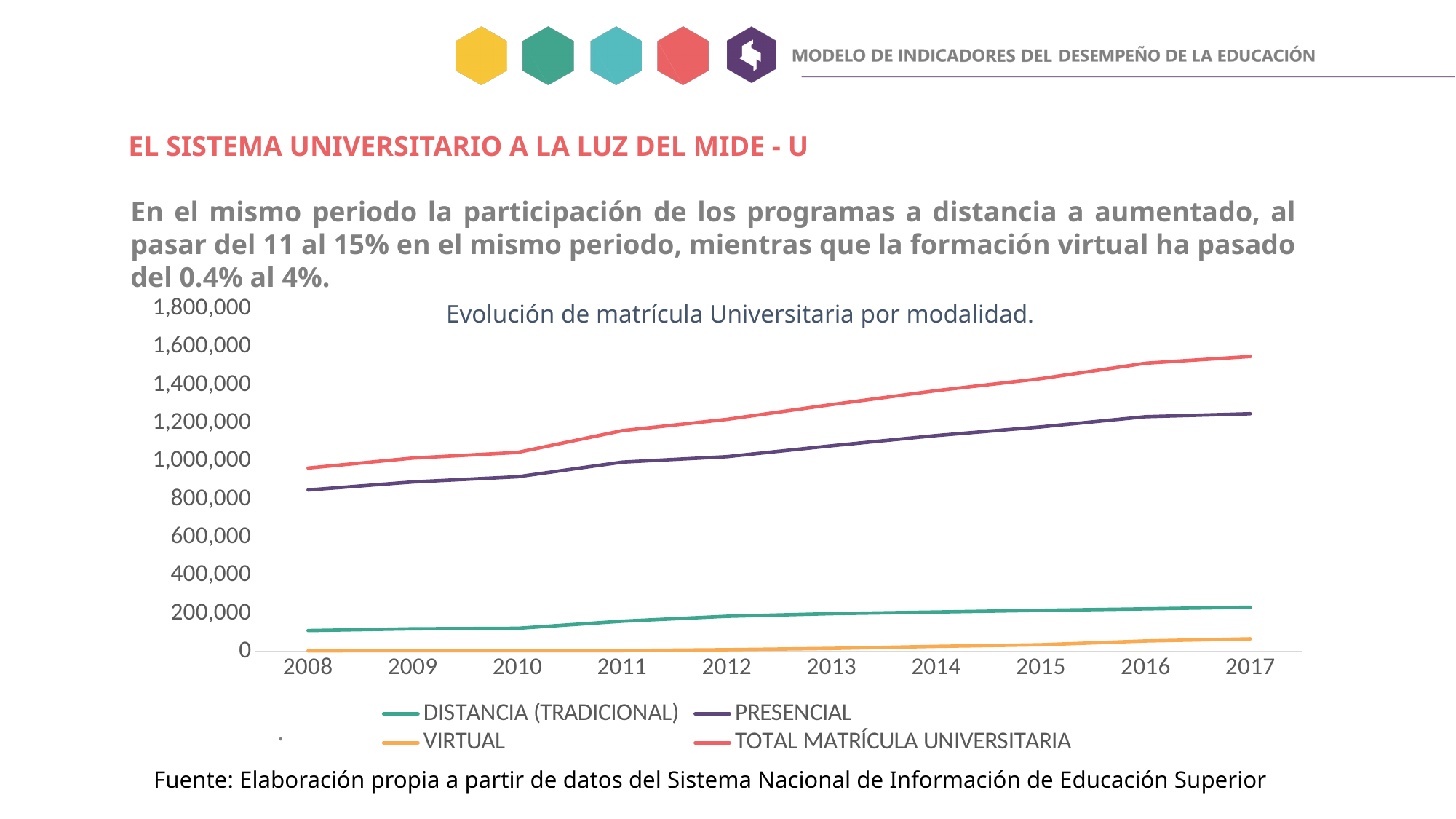
Which series has the highest values throughout the chart? TOTAL MATRÍCULA UNIVERSITARIA How many years are shown on the x axis of the chart? 10 Is the value for TOTAL MATRÍCULA UNIVERSITARIA in 2008 greater or less than 1,000,000? less What kind of chart is shown on the slide? line chart In 2012, which is larger: PRESENCIAL or DISTANCIA (TRADICIONAL)? PRESENCIAL What is the title of the chart? Evolución de matrícula Universitaria por modalidad. Does the TOTAL MATRÍCULA UNIVERSITARIA line rise or fall from 2008 to 2017? rise Is the value for TOTAL MATRÍCULA UNIVERSITARIA in 2017 greater or less than 1,400,000? greater Is the value for VIRTUAL in 2017 greater or less than 200,000? less Which series has the lowest values throughout the chart? VIRTUAL How many series does the chart legend list? 4